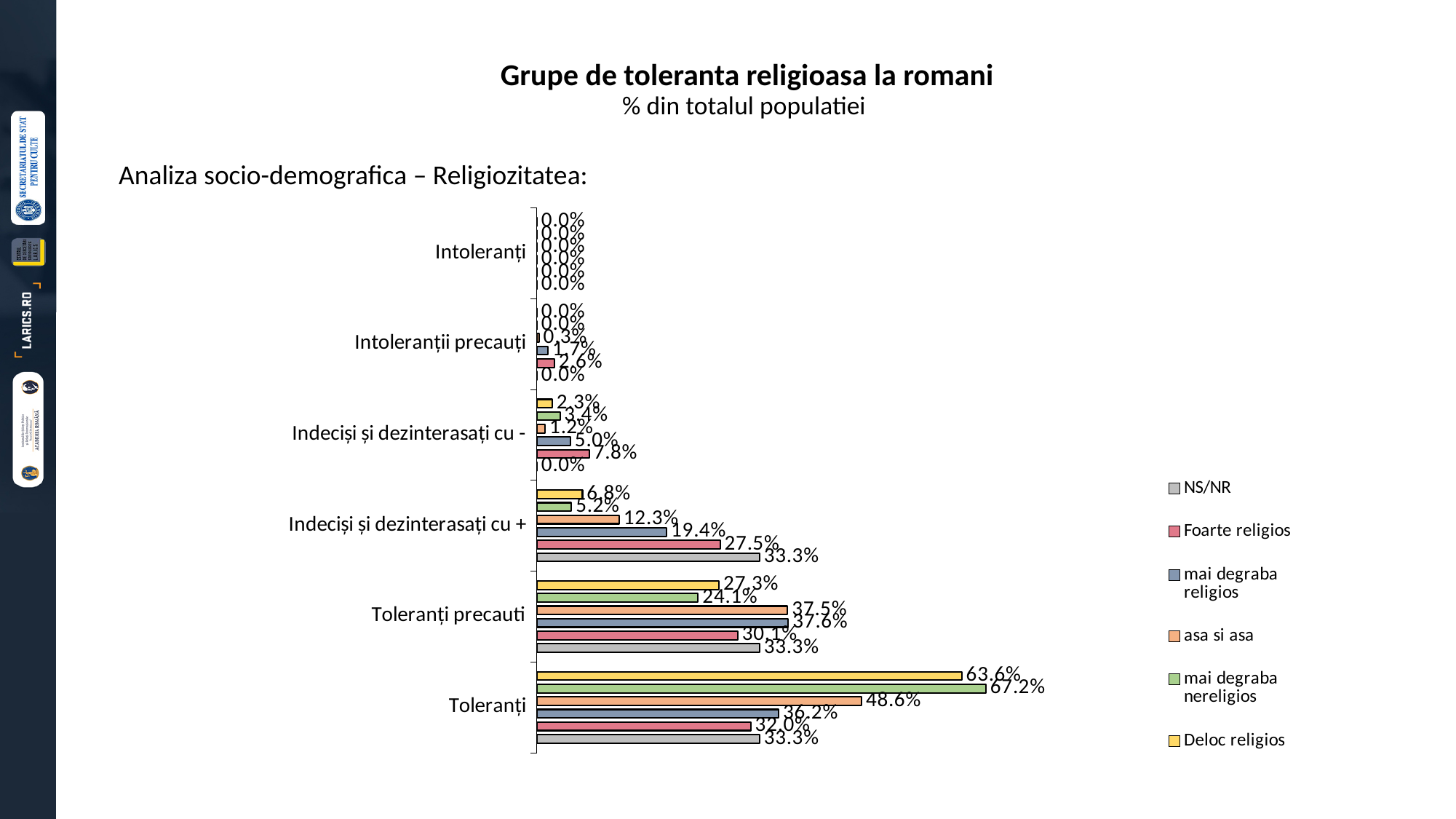
What is the value for 'asa si asa' in the 'Toleranți' category? 48.6% Which is larger in the 'Indeciși și dezinterasați cu +' category: 'asa si asa' or 'mai degraba religios'? mai degraba religios What kind of chart is shown on the slide? bar chart What is the difference between 'Deloc religios' and 'Foarte religios' in the 'Toleranți' category? 31.6% What is the value for 'Foarte religios' in the 'Indeciși și dezinterasați cu +' category? 27.5% How many categories are shown on the vertical axis? 6 What is the value for 'Deloc religios' in the 'Toleranți precauti' category? 27.3% How many series does the legend list? 6 What is the value for 'mai degraba nereligios' in the 'Toleranți' category? 67.2% What is the value for 'Foarte religios' in the 'Indeciși și dezinterasați cu -' category? 7.8% Which series has the highest value in the 'Toleranți' category? mai degraba nereligios What is the subtitle shown under the chart title? % din totalul populatiei